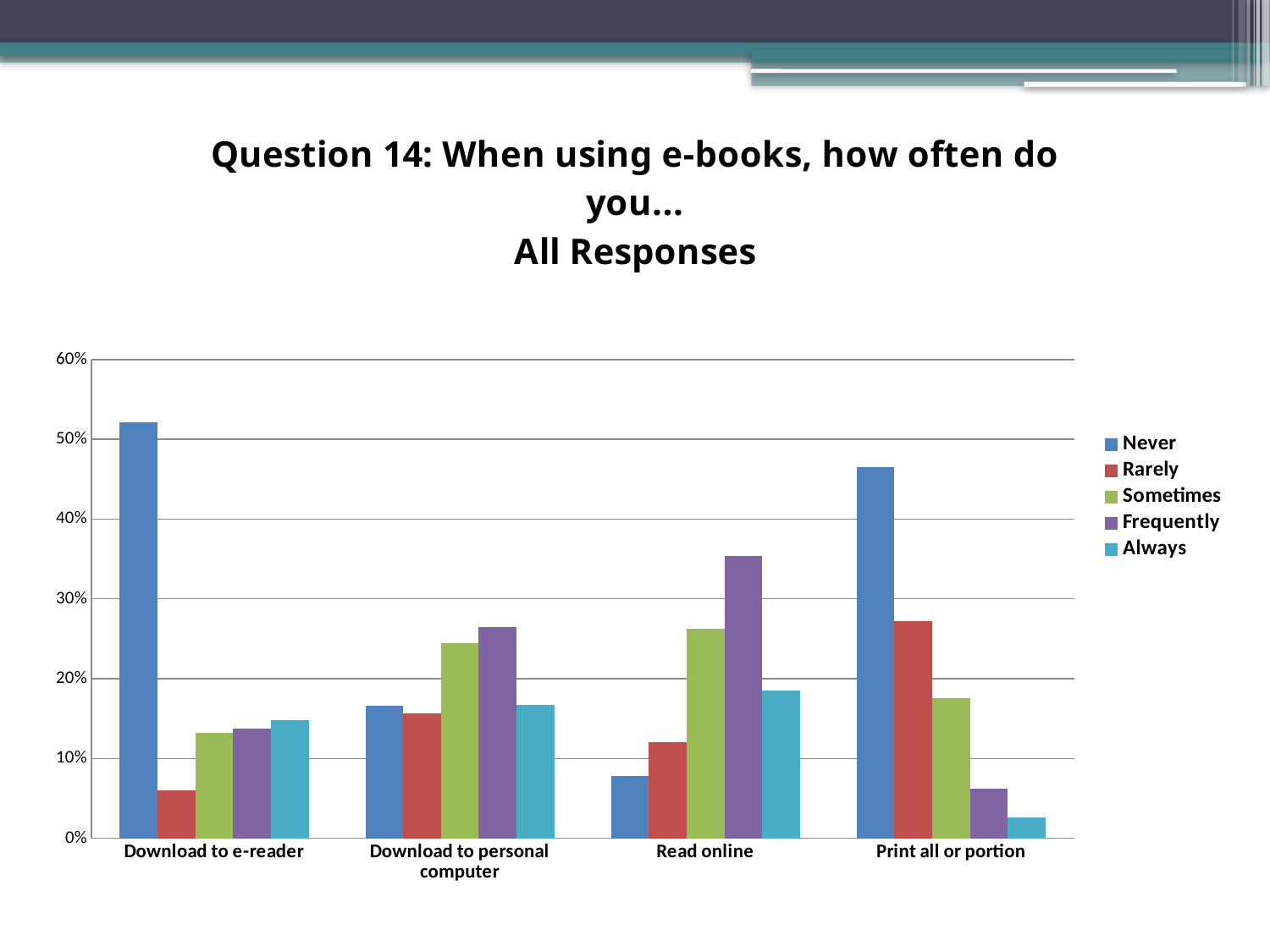
What kind of chart is shown on the slide? Bar chart How many series does the legend list? 5 For Read online, which response series has the highest value? Frequently Which category has the lowest value for the Always series? Print all or portion Which category has the highest value for the Never series? Download to e-reader Is the Always value for Print all or portion greater or less than 10%? less For Print all or portion, which is larger: the Never value or the Rarely value? Never How many categories are shown along the x axis? 4 Is the Frequently value for Read online greater or less than 30%? greater For Read online, which is larger: the Frequently value or the Sometimes value? Frequently Is the Never value for Download to e-reader greater or less than 50%? greater What are the legend entries of the chart? Never, Rarely, Sometimes, Frequently, Always